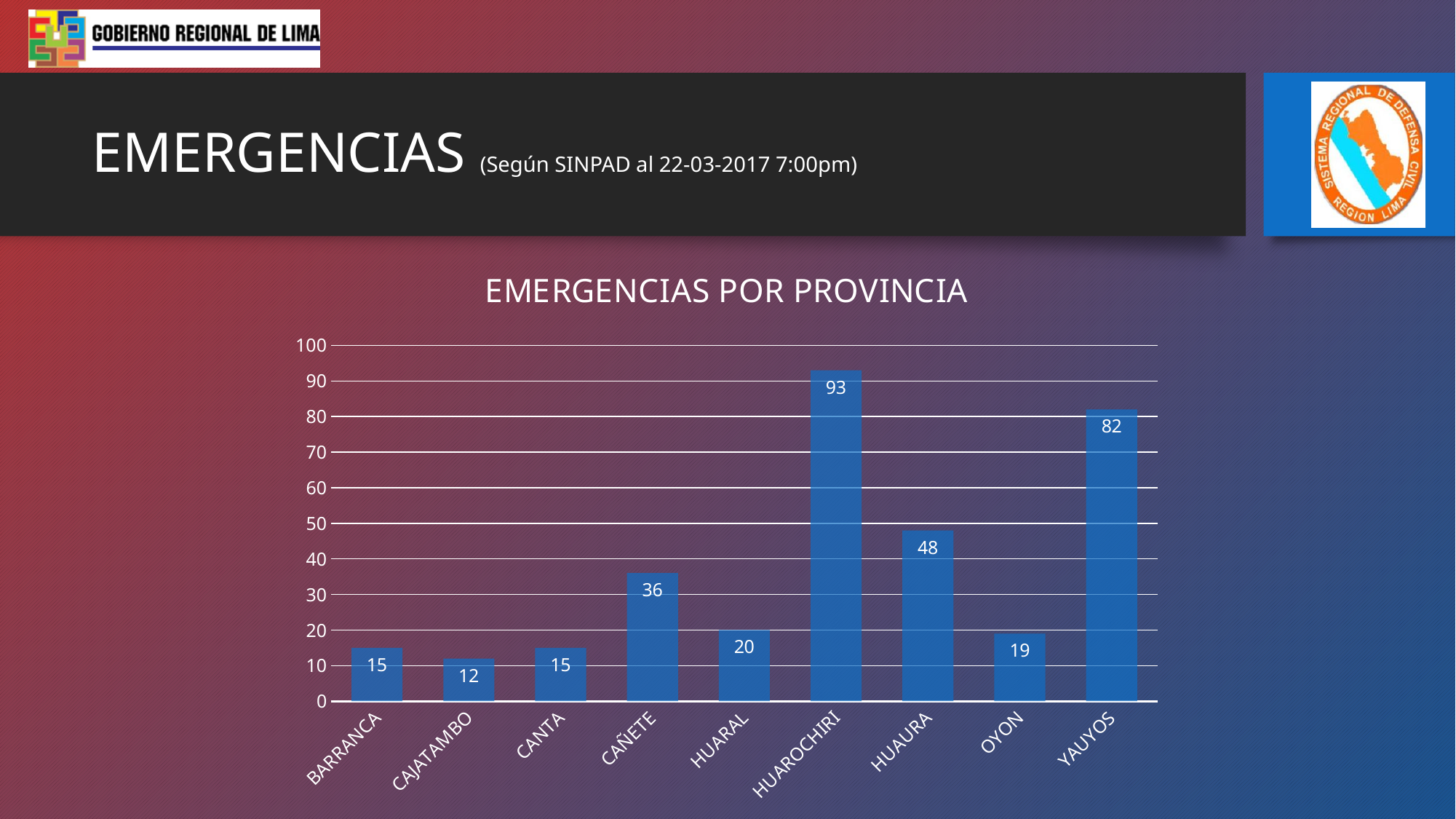
What is the title of the chart? EMERGENCIAS POR PROVINCIA What is the value for YAUYOS? 82 How many provinces are shown on the x axis? 9 What kind of chart is shown on the slide? bar chart What is the difference between the values for HUAURA and CAÑETE? 12 What is the difference between the values for HUAROCHIRI and YAUYOS? 11 Which province has the lowest number of emergencies? CAJATAMBO Which is larger, the value for HUARAL or the value for OYON? HUARAL Which province has the highest number of emergencies? HUAROCHIRI What is the value for CAJATAMBO? 12 What is the value for HUAROCHIRI? 93 Is the value for HUAURA greater or less than 40? greater